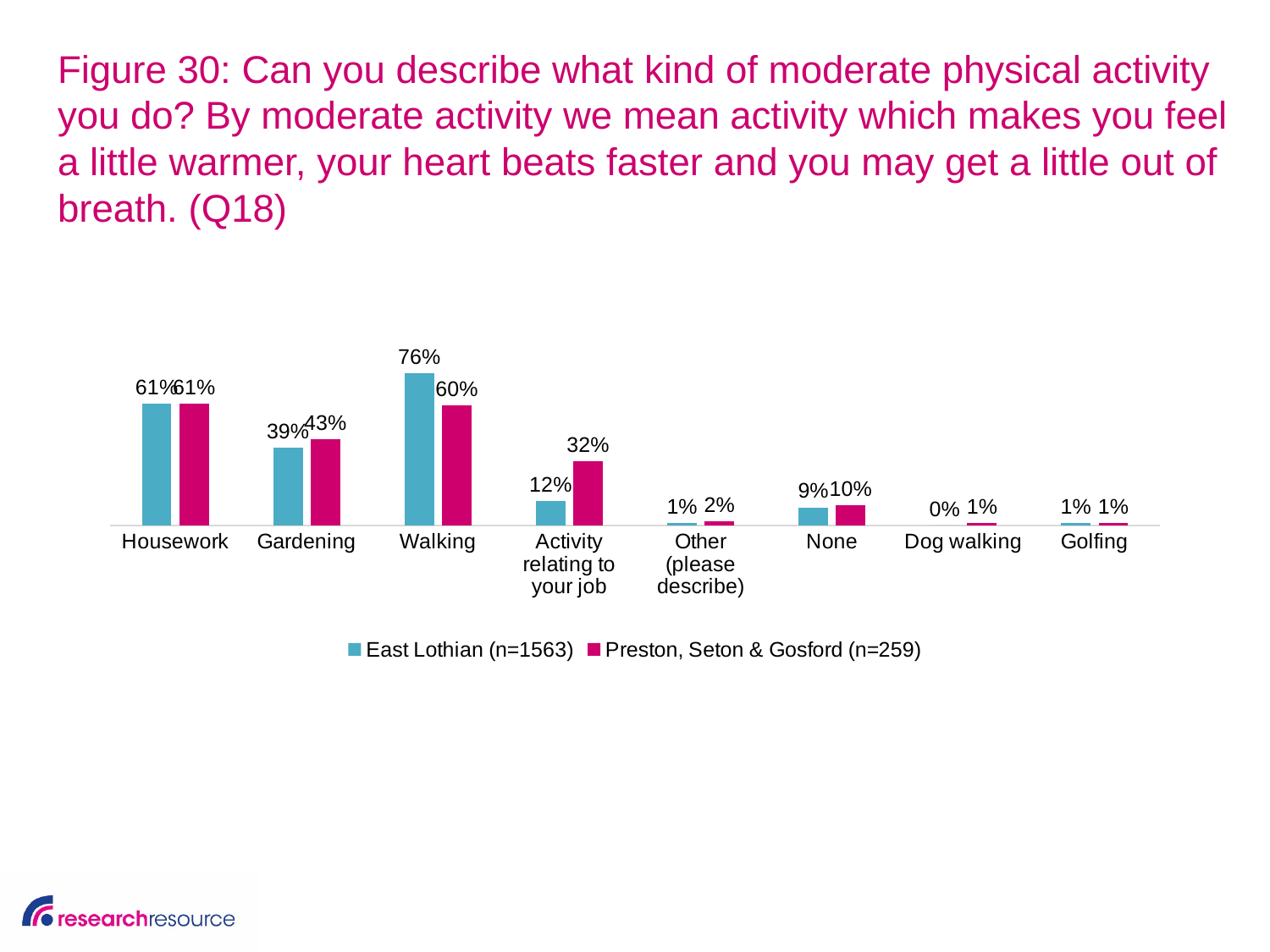
How many series does the legend list? 2 How many activity categories are shown on the x axis? 8 What is the value for Gardening in the Preston, Seton & Gosford series? 43% For Gardening, which series has the larger value: East Lothian or Preston, Seton & Gosford? Preston, Seton & Gosford Which activity has the highest value for East Lothian? Walking What percentage of Preston, Seton & Gosford respondents said Activity relating to your job? 32% What is the difference between the Preston, Seton & Gosford and East Lothian values for Activity relating to your job? 20% Which activity has the lowest value for East Lothian? Dog walking What is the difference between the East Lothian and Preston, Seton & Gosford values for Walking? 16% What is the sample size (n) for the East Lothian series in the legend? 1563 What percentage of East Lothian respondents said Walking? 76% What kind of chart is shown on the slide? Bar chart